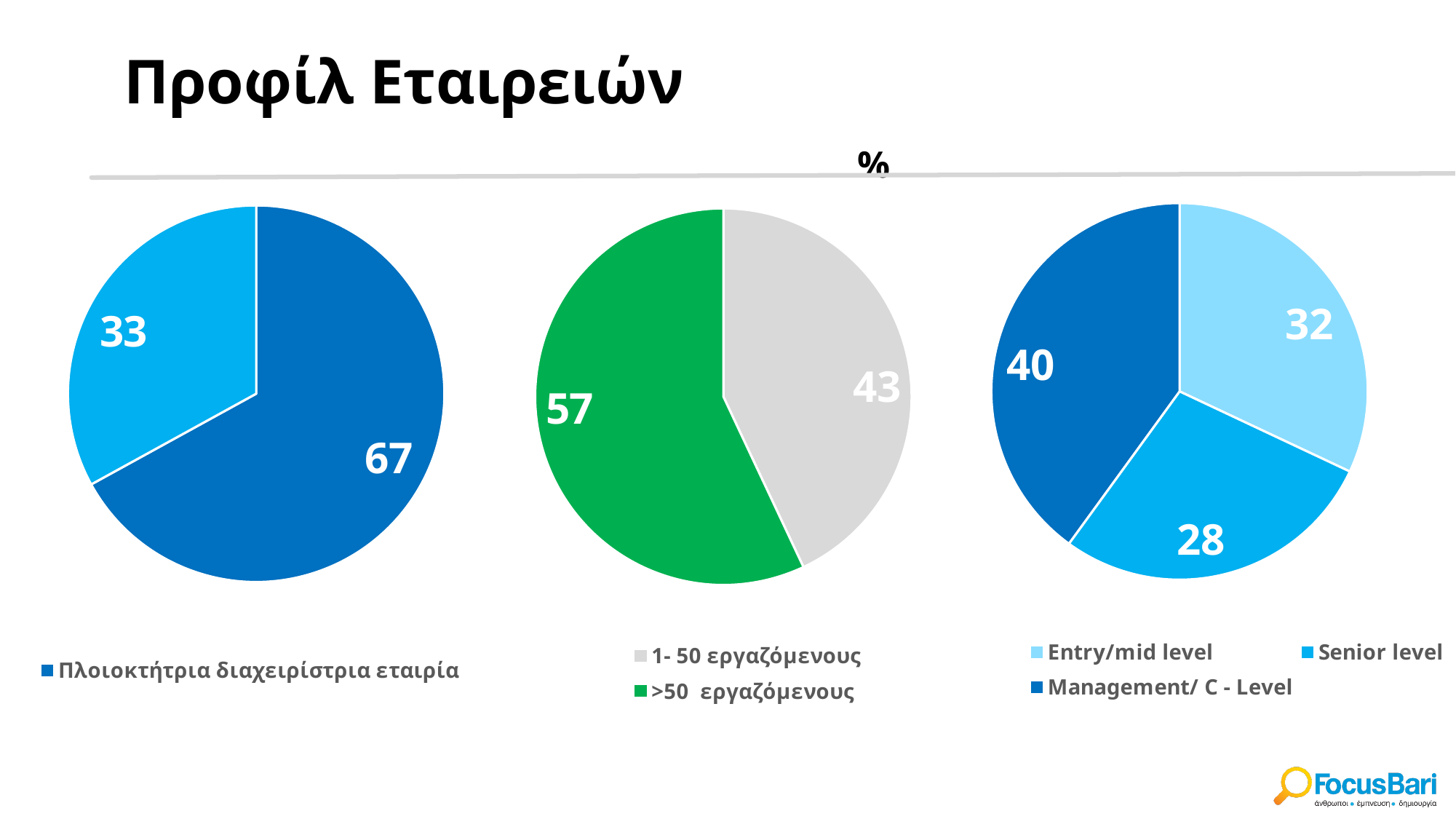
In the middle pie chart, what is the value for '1- 50 εργαζόμενους'? 43 In the right pie chart, which category has the largest slice? Management/ C - Level In the left pie chart, what is the value for 'Πλοιοκτήτρια διαχειρίστρια εταιρία'? 67 In the right pie chart, which category has the smallest slice? Senior level In the middle pie chart, which is larger: '1- 50 εργαζόμενους' or '>50 εργαζόμενους'? >50 εργαζόμενους What type of chart is the middle chart on the slide? Pie chart In the right pie chart, what is the value for 'Senior level'? 28 How many entries does the legend of the right pie chart list? 3 In the middle pie chart, what is the value for '>50 εργαζόμενους'? 57 How many slices does the right pie chart have? 3 In the right pie chart, what is the difference between 'Management/ C - Level' and 'Entry/mid level'? 8 In the right pie chart, what is the value for 'Management/ C - Level'? 40